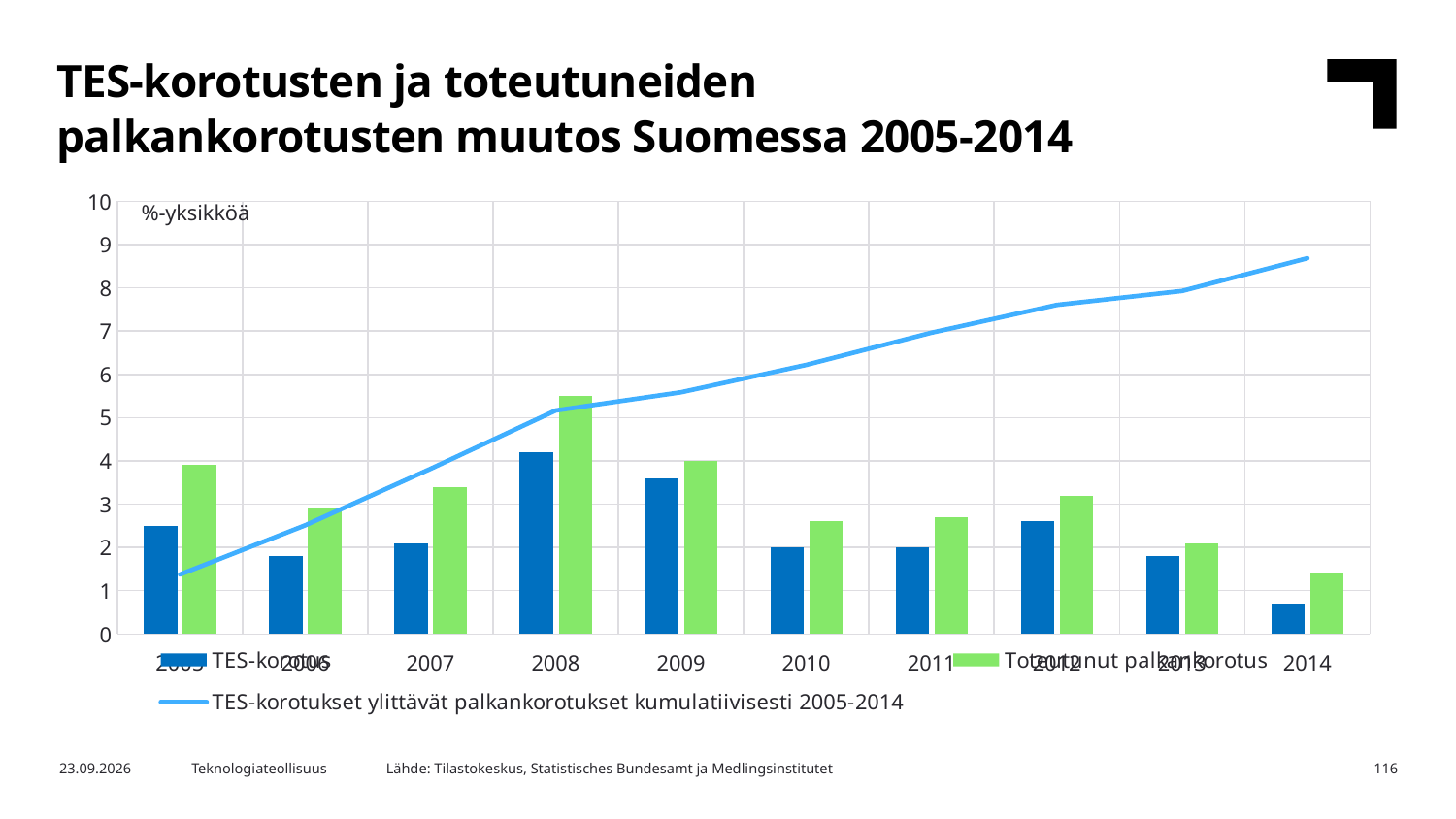
Which is larger in 2008, the TES-korotus bar or the Toteutunut palkankorotus bar? Toteutunut palkankorotus Does the cumulative line (TES-korotukset ylittävät palkankorotukset kumulatiivisesti 2005-2014) rise or fall from 2005 to 2014? rise What kind of chart is shown on the slide? bar and line chart How many years are shown on the x axis of the chart? 10 How many series does the chart's legend list? 3 Is the Toteutunut palkankorotus value for 2008 greater or less than 5? greater In which year is the TES-korotus bar the lowest? 2014 What unit label is shown at the top left of the chart's plot area? %-yksikköä In which year is the TES-korotus bar the highest? 2008 Is the value of the cumulative line (TES-korotukset ylittävät palkankorotukset kumulatiivisesti 2005-2014) in 2014 greater or less than 8? greater Is the TES-korotus value for 2014 greater or less than 1? less In which year is the Toteutunut palkankorotus bar the highest? 2008